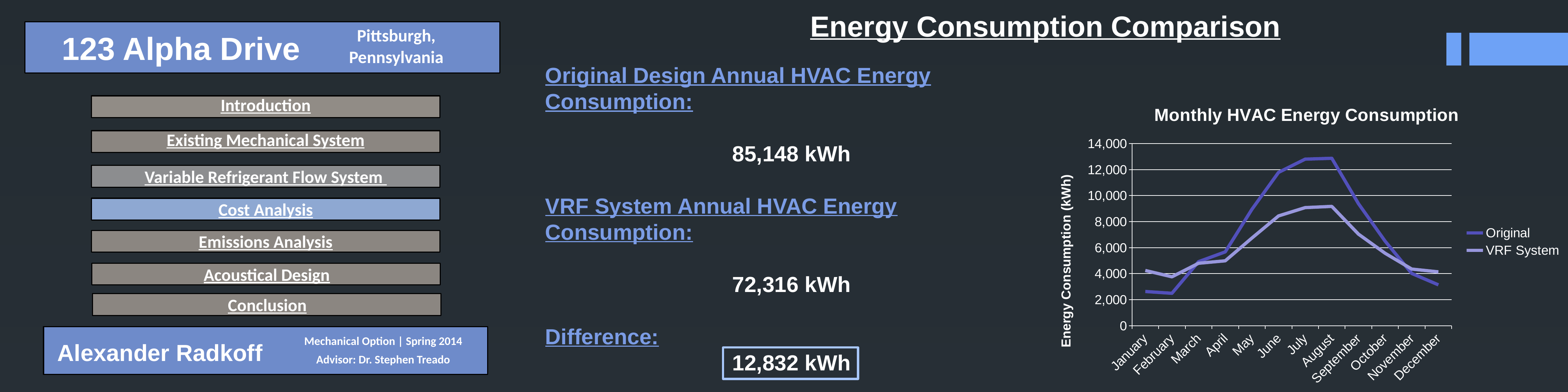
How many series does the legend of the Monthly HVAC Energy Consumption chart list? 2 In the Monthly HVAC Energy Consumption chart, does the VRF System series rise or fall from February to August? rise In the Monthly HVAC Energy Consumption chart, is the Original value for January greater or less than 4,000? less In the Monthly HVAC Energy Consumption chart, which series has the higher value in July, Original or VRF System? Original In the Monthly HVAC Energy Consumption chart, is the VRF System value for August greater or less than 10,000? less What kind of chart is the Monthly HVAC Energy Consumption chart? line chart How many months are plotted along the x axis of the Monthly HVAC Energy Consumption chart? 12 In the Monthly HVAC Energy Consumption chart, which series has the higher value in January, Original or VRF System? VRF System What is the y-axis title of the Monthly HVAC Energy Consumption chart? Energy Consumption (kWh) In the Monthly HVAC Energy Consumption chart, is the VRF System value for June greater or less than 6,000? greater In the Monthly HVAC Energy Consumption chart, does the Original series rise or fall from August to December? fall